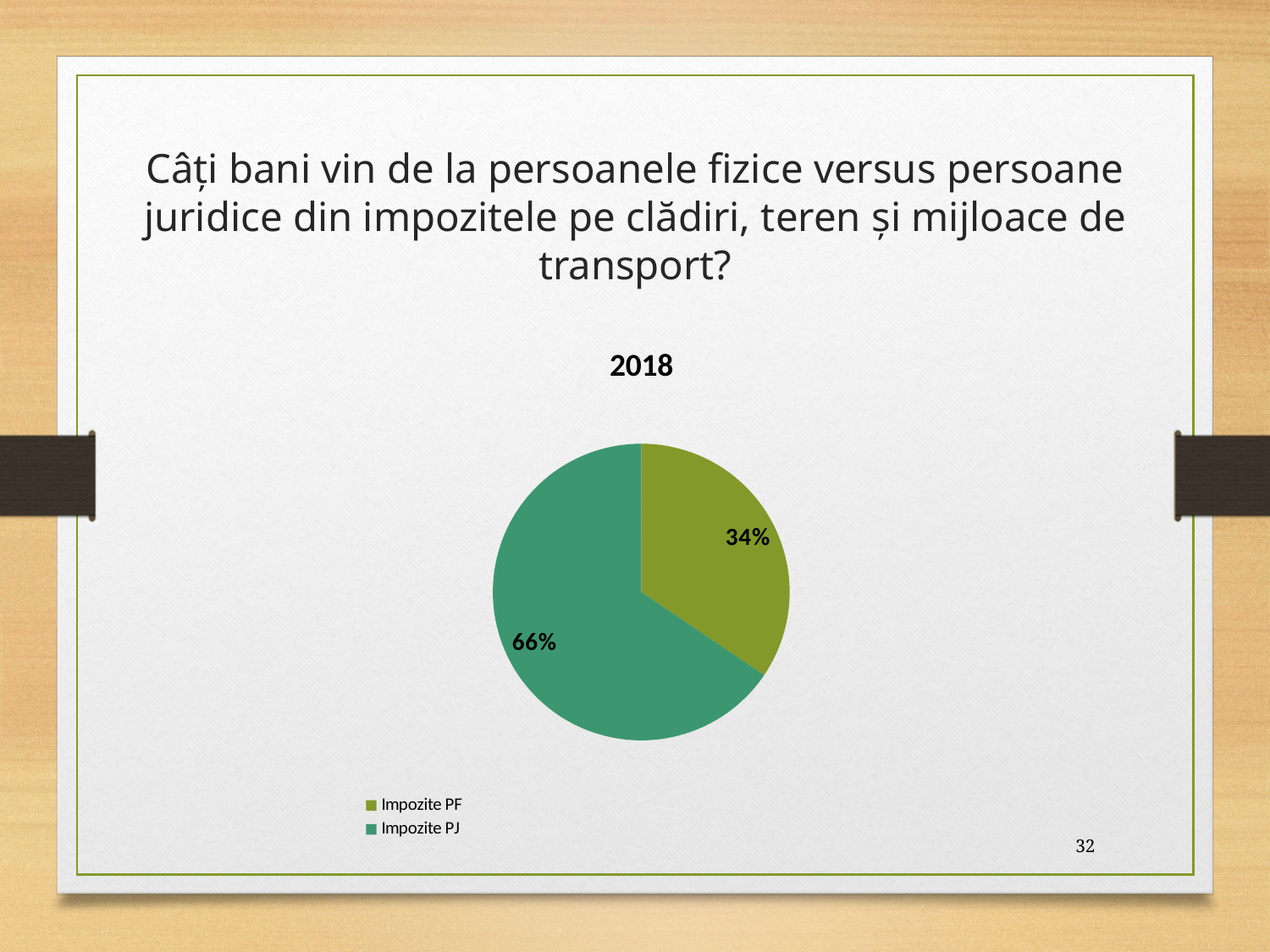
What is the difference in percentage points between Impozite PJ and Impozite PF? 32 What share of the pie does Impozite PF have? 34% What is the chart's title? 2018 Which slice is the smallest? Impozite PF Which slice is the largest? Impozite PJ Which legend entry is shown in the olive green colour? Impozite PF How many entries does the legend list? 2 Which is larger, Impozite PF or Impozite PJ? Impozite PJ What kind of chart is shown on the slide? pie chart What share of the pie does Impozite PJ have? 66% How many slices does the pie chart have? 2